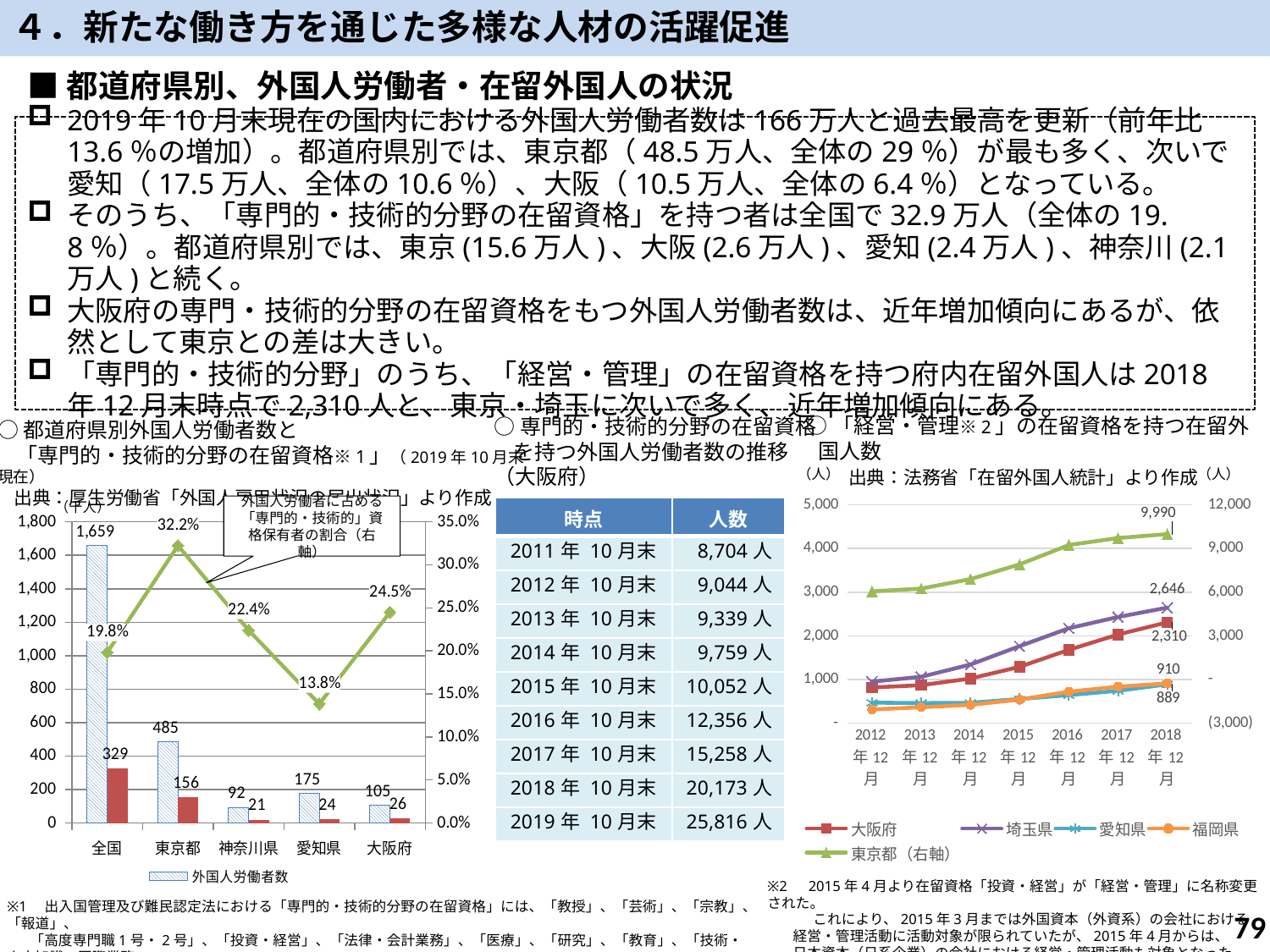
In the left chart, what is the value of the red bar for 全国? 329 In the left chart, which prefecture (excluding 全国) has the lowest percentage on the line? 愛知県 In the right chart, how many series does the legend list? 5 In the right chart, what is the value for 大阪府 in 2018年12月? 2,310 In the left chart, what percentage is shown on the line for 東京都? 32.2% In the left chart, which is larger: the red bar for 愛知県 or the red bar for 大阪府? 大阪府 In the left chart, how many categories are shown on the x axis? 5 In the right chart (「経営・管理」の在留資格を持つ在留外国人数), what is the value for 東京都 in 2018年12月? 9,990 In the left chart, what is the difference between the 外国人労働者数 bars for 愛知県 and 大阪府? 70 In the right chart, does the 大阪府 series rise or fall from 2012 to 2018? rise In the left chart (都道府県別外国人労働者数と「専門的・技術的分野の在留資格」), what is the number of foreign workers (外国人労働者数) for 東京都? 485 In the right chart, is the value for 埼玉県 in 2015年12月 greater or less than 2,000? less